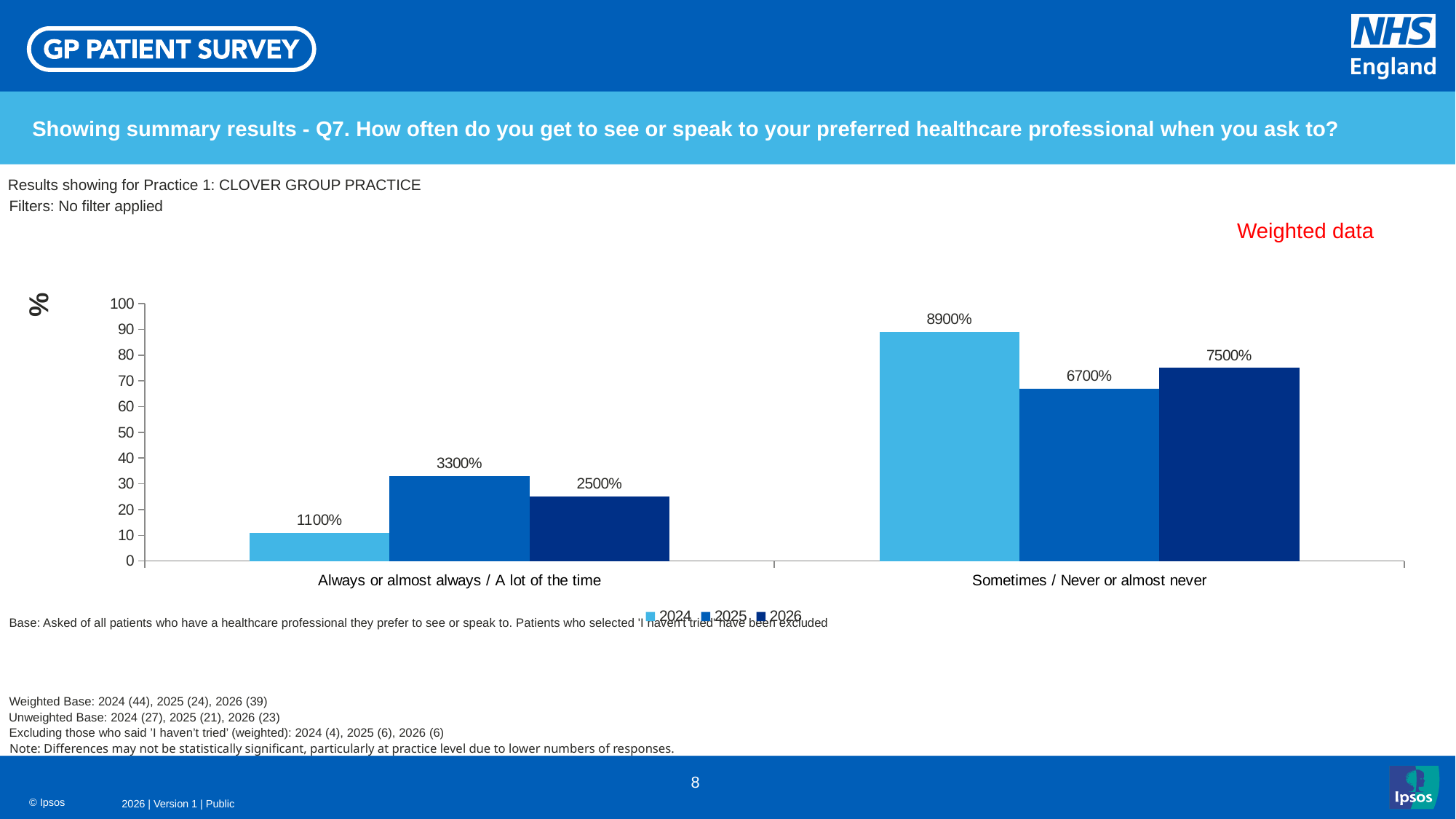
How many categories are shown on the x axis? 2 Which year has the highest bar in the 'Sometimes / Never or almost never' category? 2024 What is the data label for 2024 in the 'Always or almost always / A lot of the time' category? 1100% Which is larger in the 'Sometimes / Never or almost never' category: the 2025 bar or the 2026 bar? 2026 Which year has the lowest bar in the 'Always or almost always / A lot of the time' category? 2024 What is the data label for 2025 in the 'Always or almost always / A lot of the time' category? 3300% What is the data label for 2024 in the 'Sometimes / Never or almost never' category? 8900% Which practice are the results shown for? Practice 1: CLOVER GROUP PRACTICE How many series does the legend list? 3 What is the data label for 2026 in the 'Sometimes / Never or almost never' category? 7500% Is the 2026 bar for 'Always or almost always / A lot of the time' greater or less than 30 on the axis? less What kind of chart is shown on the slide? Bar chart